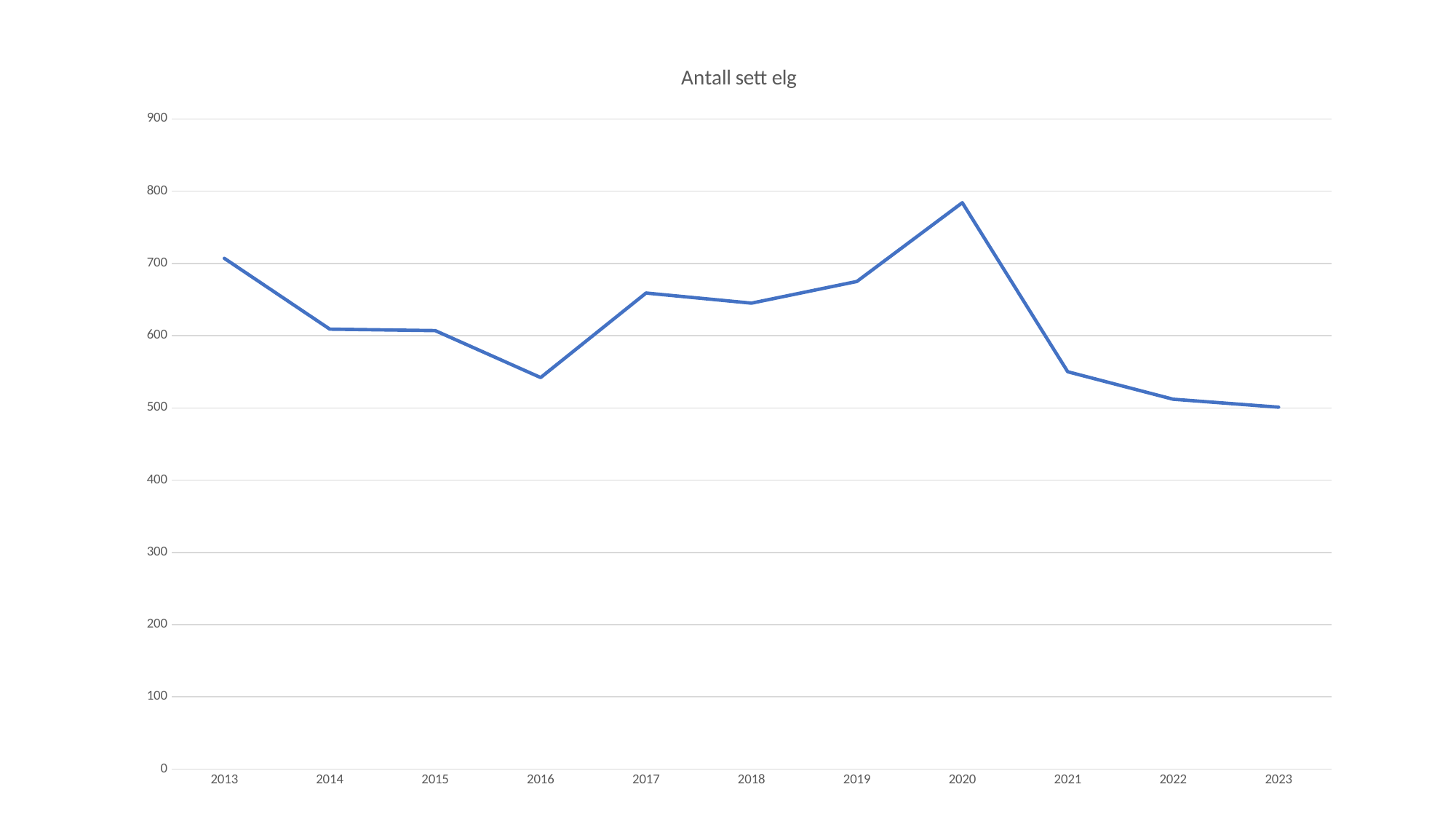
Is the value for 2020 greater or less than 700? greater Is the value for 2021 greater or less than 600? less Which year has the lowest value? 2023 How many years are plotted on the x axis? 11 Which year has the highest value? 2020 What type of chart is shown on the slide? Line chart Which is larger, the value for 2013 or the value for 2014? 2013 Do the values rise or fall from 2020 to 2023? fall Is the value for 2016 greater or less than 600? less What is the title of the chart? Antall sett elg Which is larger, the value for 2016 or the value for 2017? 2017